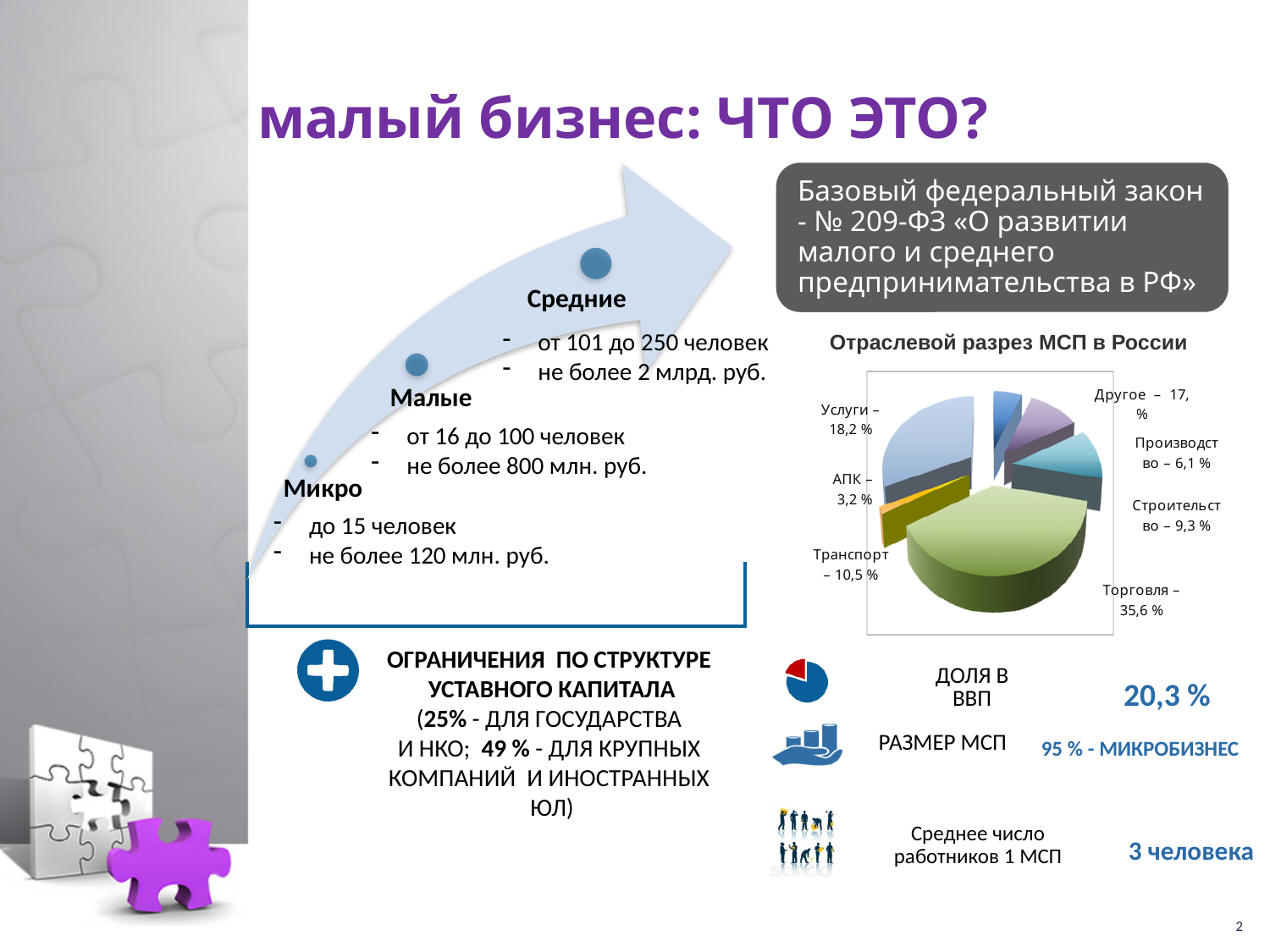
In the pie chart, what share does Торговля have? 35,6 % In the pie chart, what share does Строительство have? 9,3 % In the pie chart, what is the difference between the shares of Торговля and Услуги? 17,4 % In the pie chart, what share does Услуги have? 18,2 % In the pie chart, which is larger: Строительство or Производство? Строительство In the pie chart, what share does Транспорт have? 10,5 % What kind of chart is shown under the title "Отраслевой разрез МСП в России"? pie chart In the pie chart, what share does Производство have? 6,1 % In the pie chart, what share does АПК have? 3,2 % Which sector has the largest slice in the pie chart? Торговля What is the title of the pie chart on the slide? Отраслевой разрез МСП в России Which sector has the smallest slice in the pie chart? АПК